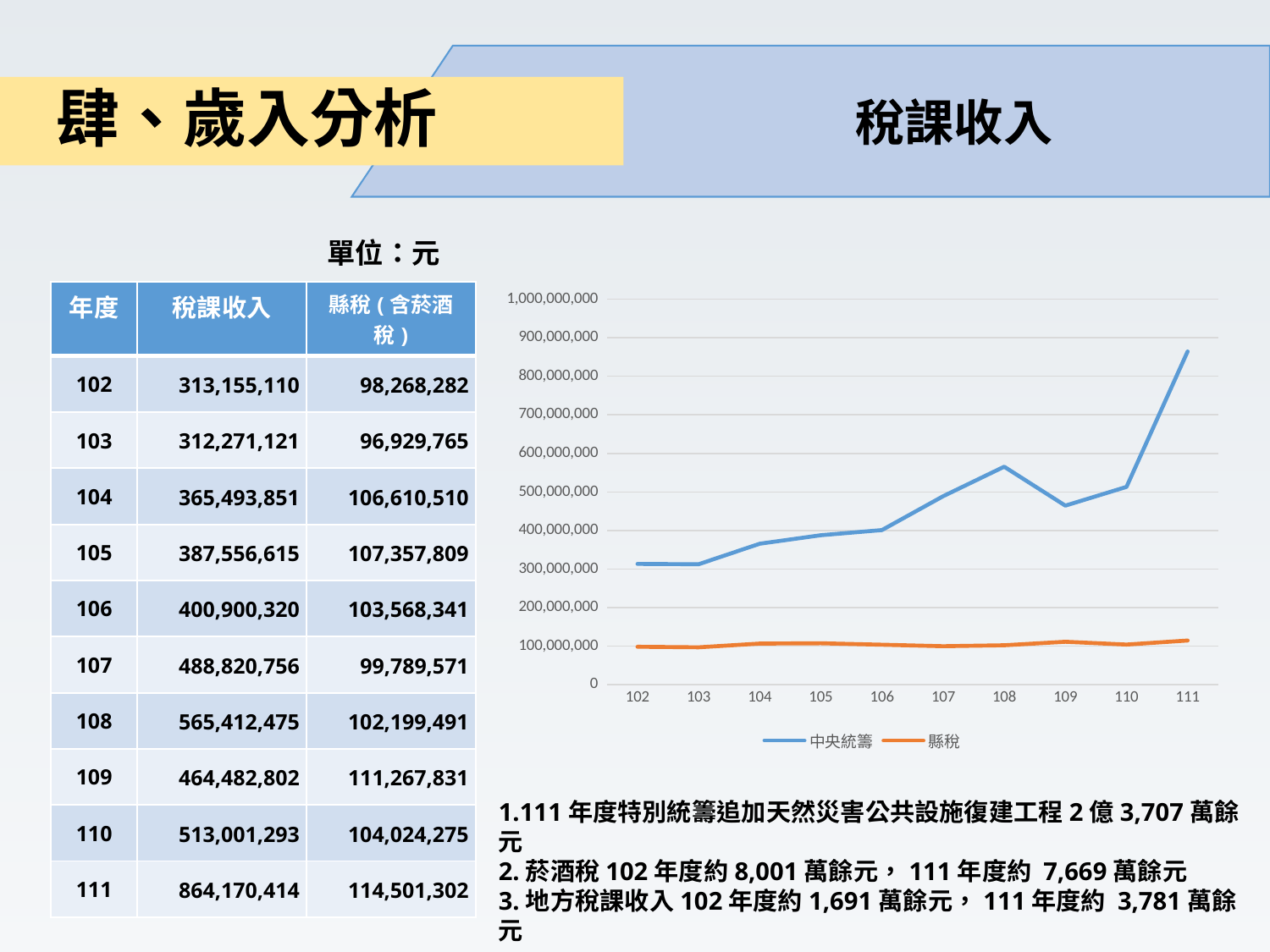
In which year does the 中央統籌 line reach its highest value? 111 In year 111, which series has the larger value, 中央統籌 or 縣稅? 中央統籌 Is the value of 中央統籌 in year 102 greater or less than 400,000,000? less How many series does the chart's legend list? 2 Is the value of 中央統籌 in year 111 greater or less than 800,000,000? greater How many years are plotted along the x axis of the chart? 10 What kind of chart is shown on the slide? line chart Which is larger for 中央統籌: the value in year 108 or the value in year 109? 108 Is the value of 中央統籌 in year 108 greater or less than 500,000,000? greater Does the 中央統籌 line rise or fall between year 108 and year 109? fall What colour is the 縣稅 line in the chart? orange